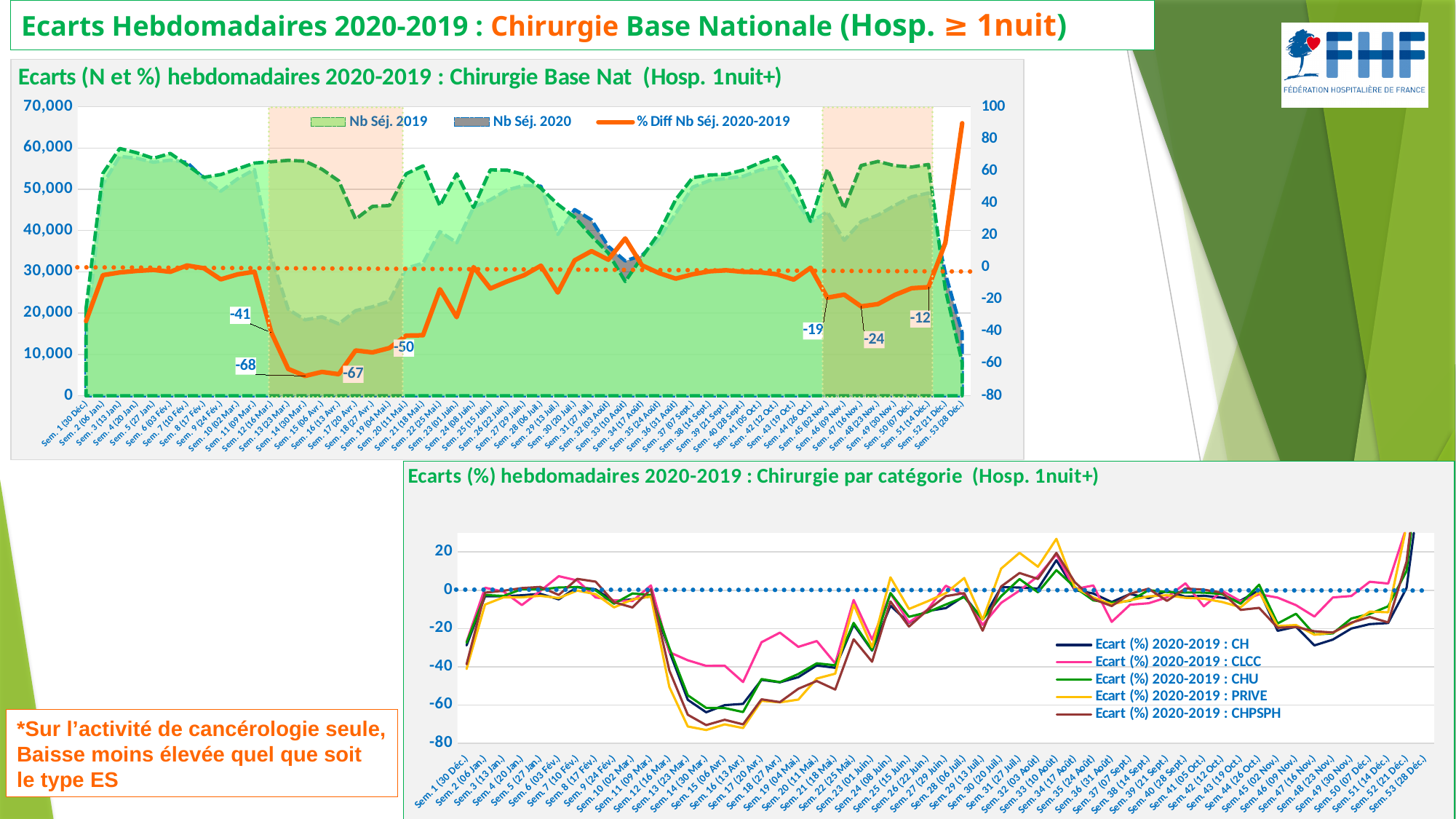
In the bottom chart, how many series does the legend list? 5 In the bottom chart, is the value for PRIVE at Sem. 14 (30 Mar.) greater or less than -60? less In the top chart, how many data labels are printed on the % Diff Nb Séj. 2020-2019 line? 7 In the bottom chart, which series has the highest value at Sem. 14 (30 Mar.)? Ecart (%) 2020-2019 : CLCC In the top chart, does the % Diff Nb Séj. 2020-2019 line rise or fall over the last weeks (Sem. 51 to Sem. 53)? rise What kind of chart is the bottom chart (Ecarts (%) hebdomadaires 2020-2019 : Chirurgie par catégorie)? Line chart In the top chart, how many series does the legend list? 3 In the top chart, what is the maximum value shown on the left vertical axis? 70,000 In the bottom chart, is the value for CLCC at Sem. 18 (27 Avr.) greater or less than -40? greater In the top chart, what is the highest (least negative) value printed as a data label on the % Diff Nb Séj. 2020-2019 line? -12 In the top chart, what is the lowest value printed as a data label on the % Diff Nb Séj. 2020-2019 line? -68 In the top chart, what is the difference between the labelled values -12 and -68? 56